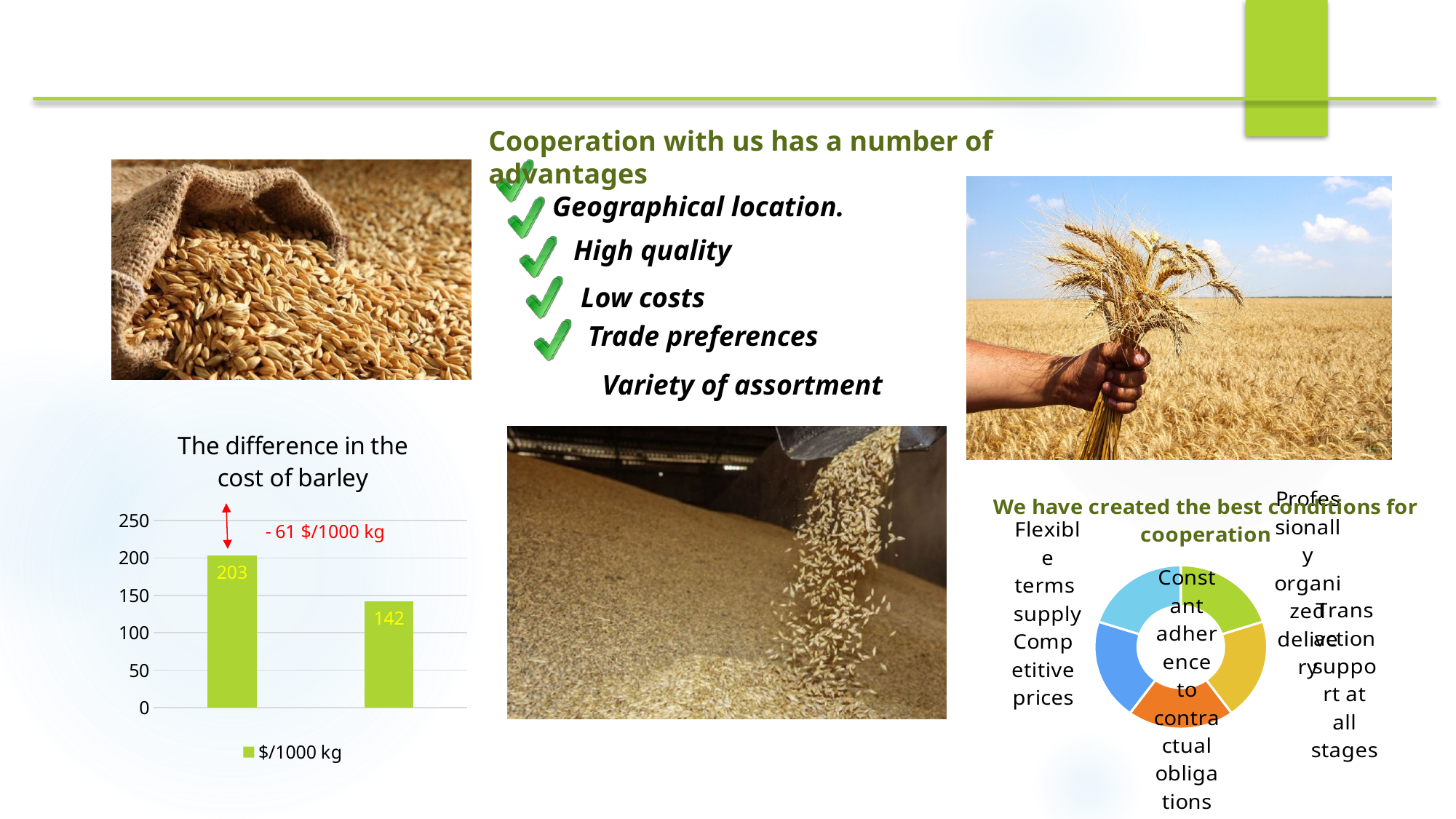
In the chart titled 'The difference in the cost of barley', what is the value of the right bar? 142 In the chart titled 'The difference in the cost of barley', is the value of the right bar greater or less than 150? less In the chart titled 'The difference in the cost of barley', what is the value of the left bar? 203 What kind of chart is 'The difference in the cost of barley'? bar chart In the chart titled 'The difference in the cost of barley', what is the legend entry? $/1000 kg What kind of chart is shown under the heading 'We have created the best conditions for cooperation'? doughnut chart In the chart titled 'The difference in the cost of barley', which bar is higher, the left or the right? left In the chart titled 'The difference in the cost of barley', how many bars are plotted? 2 In the chart titled 'The difference in the cost of barley', how many series does the legend list? 1 How many segments does the doughnut chart under 'We have created the best conditions for cooperation' have? 5 In the chart titled 'The difference in the cost of barley', what is the difference between the left bar and the right bar? 61 In the chart titled 'The difference in the cost of barley', what difference is written in red next to the arrow? - 61 $/1000 kg